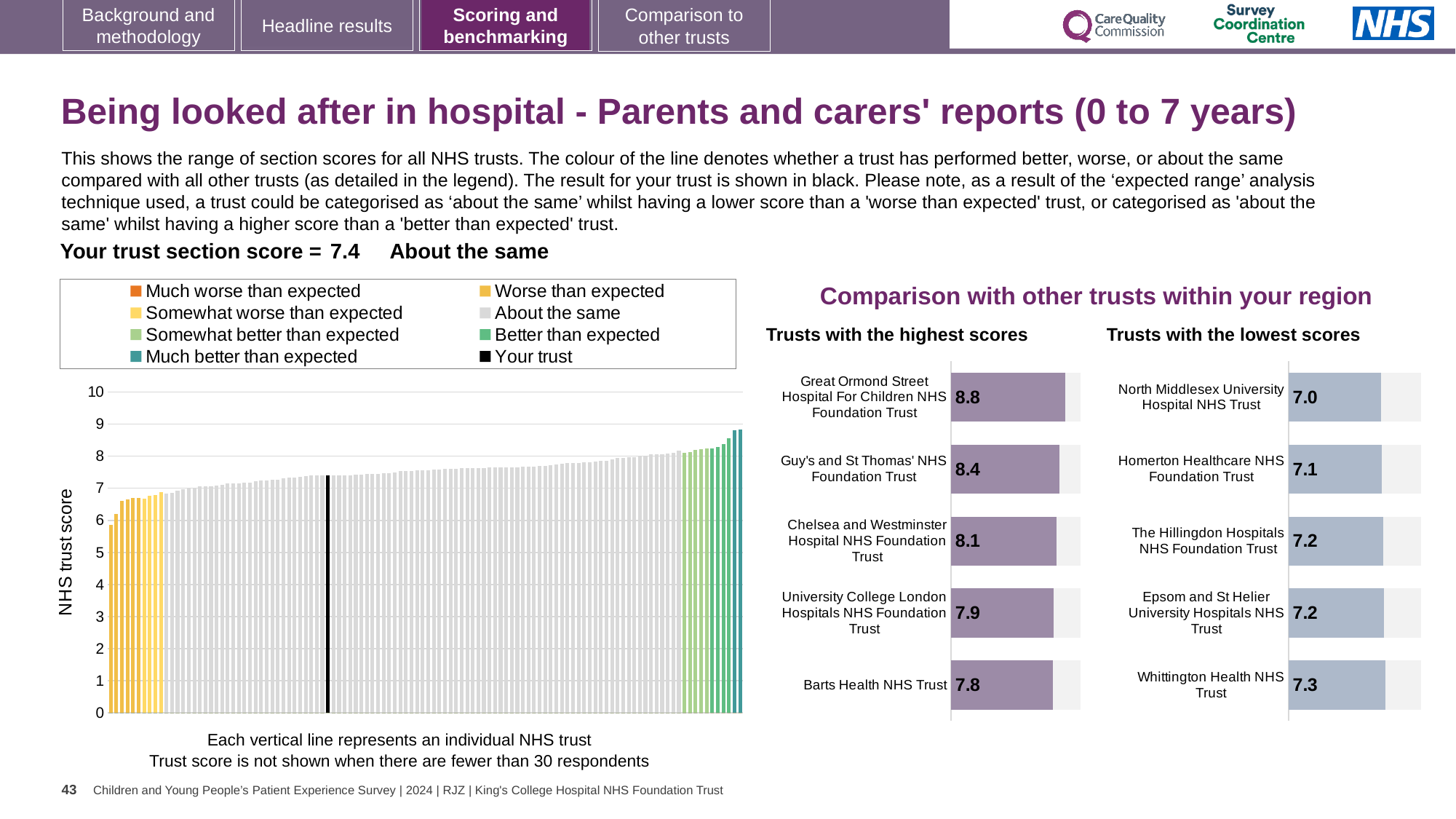
In the 'Trusts with the highest scores' chart, which trust has the highest score? Great Ormond Street Hospital For Children NHS Foundation Trust In the 'Trusts with the highest scores' chart, what is the score for Great Ormond Street Hospital For Children NHS Foundation Trust? 8.8 In the large chart on the left, is the value for the black bar (Your trust) greater or less than 7? greater In the large chart on the left, do the trust scores rise or fall from left to right? rise In the 'Trusts with the highest scores' chart, what is the difference between the scores of Great Ormond Street Hospital For Children NHS Foundation Trust and Barts Health NHS Trust? 1.0 In the 'Trusts with the highest scores' chart, what is the score for Barts Health NHS Trust? 7.8 How many entries does the legend of the large chart on the left list? 8 In the 'Trusts with the lowest scores' chart, what is the score for North Middlesex University Hospital NHS Trust? 7.0 In the 'Trusts with the lowest scores' chart, which trust has the lowest score? North Middlesex University Hospital NHS Trust How many trusts are shown in the 'Trusts with the highest scores' chart? 5 In the 'Trusts with the lowest scores' chart, what is the score for Whittington Health NHS Trust? 7.3 In the 'Trusts with the lowest scores' chart, which has the larger score: Homerton Healthcare NHS Foundation Trust or Whittington Health NHS Trust? Whittington Health NHS Trust